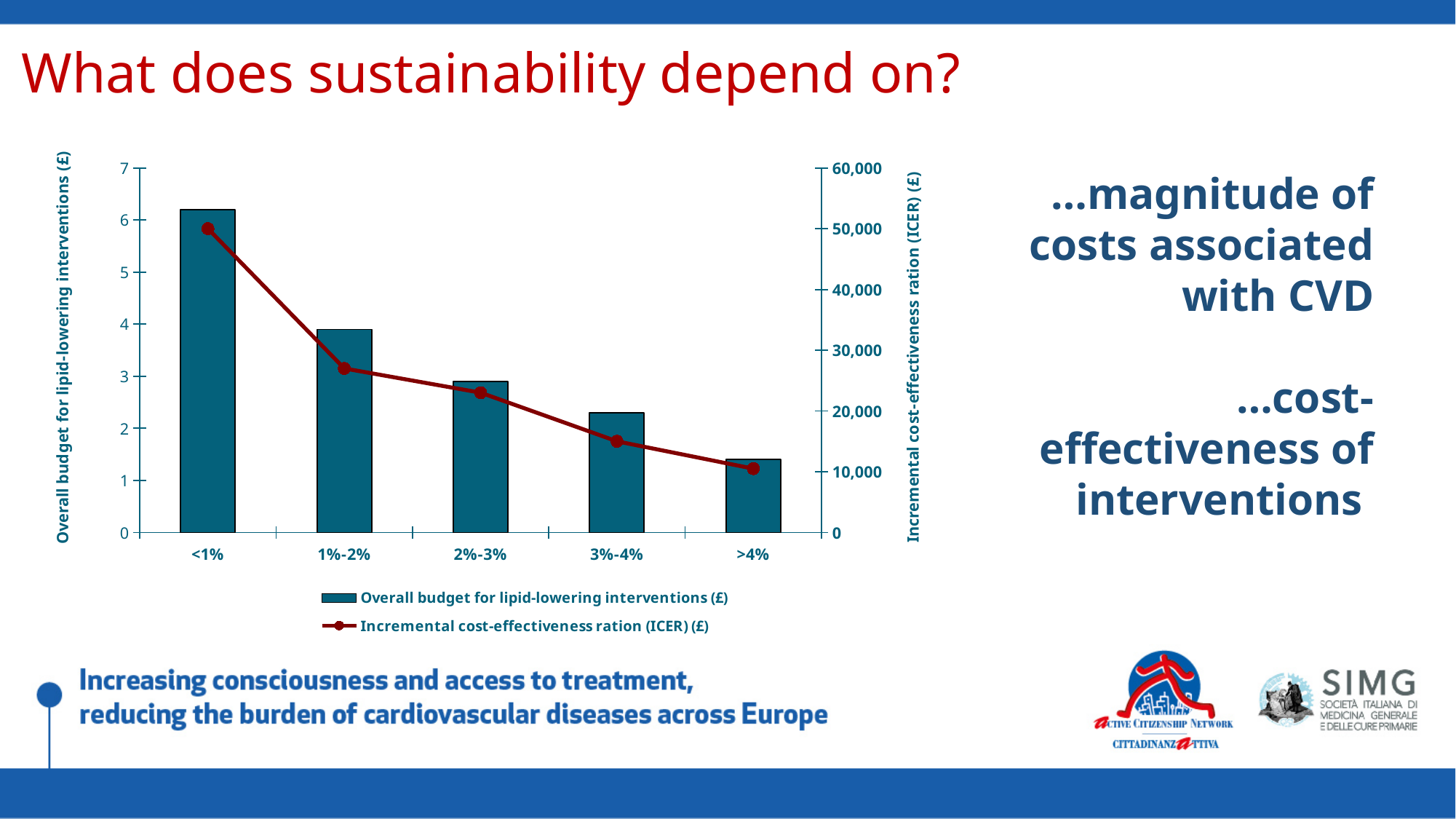
Is the Incremental cost-effectiveness ratio (ICER) for <1% greater or less than 40,000? greater Is the Incremental cost-effectiveness ratio (ICER) for 1%-2% greater or less than 20,000? greater Do the values of the Incremental cost-effectiveness ratio (ICER) rise or fall from <1% to >4%? Fall Which series is plotted as a line in the chart? Incremental cost-effectiveness ration (ICER) (£) Which category has the lowest overall budget for lipid-lowering interventions? >4% How many series does the legend list? 2 Is the overall budget for lipid-lowering interventions for >4% greater or less than 2? less Which category has the highest overall budget for lipid-lowering interventions? <1% What kind of chart is shown on the slide? Combined bar and line chart How many categories are shown on the x axis? 5